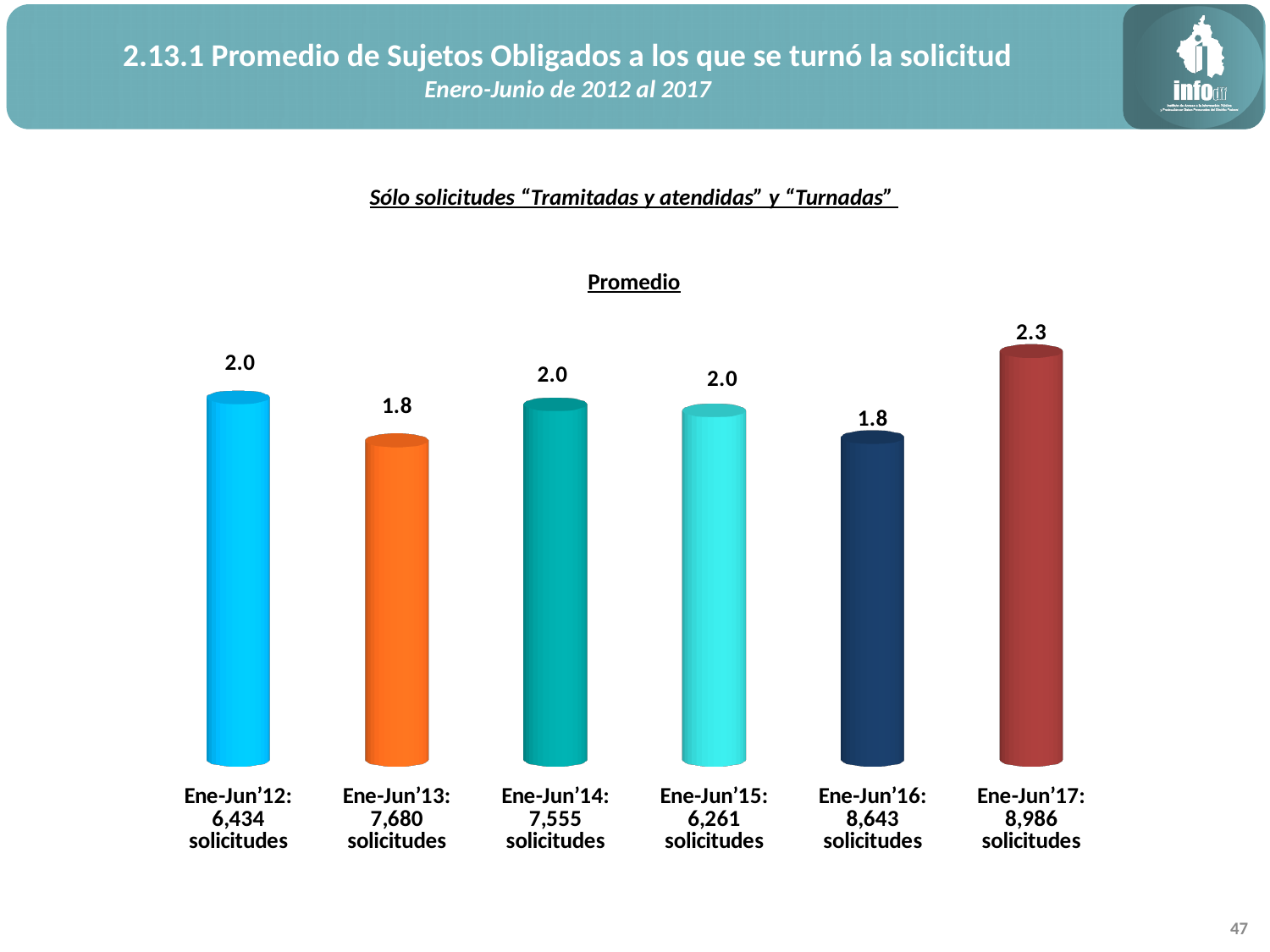
What is the title printed above the bars of the chart? Promedio How many periods (bars) are shown in the chart? 6 Which is larger, the average value for Ene-Jun'14 or for Ene-Jun'16? Ene-Jun'14 What kind of chart is shown on the slide? Bar chart How many solicitudes are listed for Ene-Jun'16 in the category label? 8,643 What is the average value shown for Ene-Jun'12? 2.0 What colour is the bar for Ene-Jun'13? Orange How many solicitudes are listed for Ene-Jun'15 in the category label? 6,261 Which period has the highest average value? Ene-Jun'17 What is the average (Promedio) value shown for Ene-Jun'17? 2.3 What is the difference between the average values for Ene-Jun'17 and Ene-Jun'16? 0.5 What is the average value shown for Ene-Jun'13? 1.8